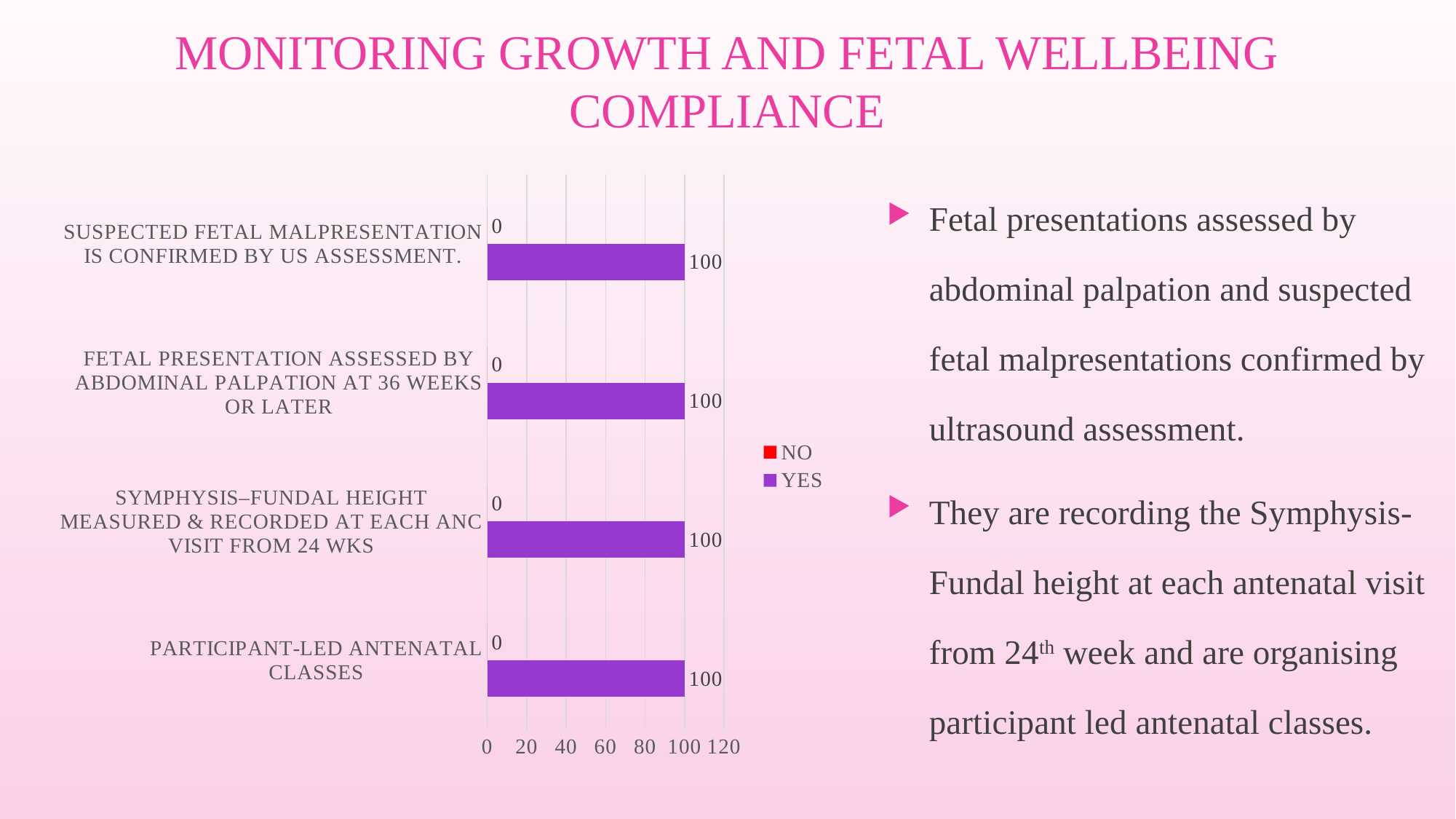
What is the difference between the YES and NO values for PARTICIPANT-LED ANTENATAL CLASSES? 100 How many series does the legend list? 2 What is the NO value for SUSPECTED FETAL MALPRESENTATION IS CONFIRMED BY US ASSESSMENT.? 0 What colour are the YES bars in the chart? purple What are the two entries in the chart legend? NO and YES What is the YES value for PARTICIPANT-LED ANTENATAL CLASSES? 100 What is the NO value for SYMPHYSIS–FUNDAL HEIGHT MEASURED & RECORDED AT EACH ANC VISIT FROM 24 WKS? 0 Which is larger for SYMPHYSIS–FUNDAL HEIGHT MEASURED & RECORDED AT EACH ANC VISIT FROM 24 WKS, the YES value or the NO value? YES What kind of chart is shown on the slide? bar chart Is the YES value for FETAL PRESENTATION ASSESSED BY ABDOMINAL PALPATION AT 36 WEEKS OR LATER greater or less than 80? greater How many categories are shown on the chart? 4 What is the YES value for FETAL PRESENTATION ASSESSED BY ABDOMINAL PALPATION AT 36 WEEKS OR LATER? 100